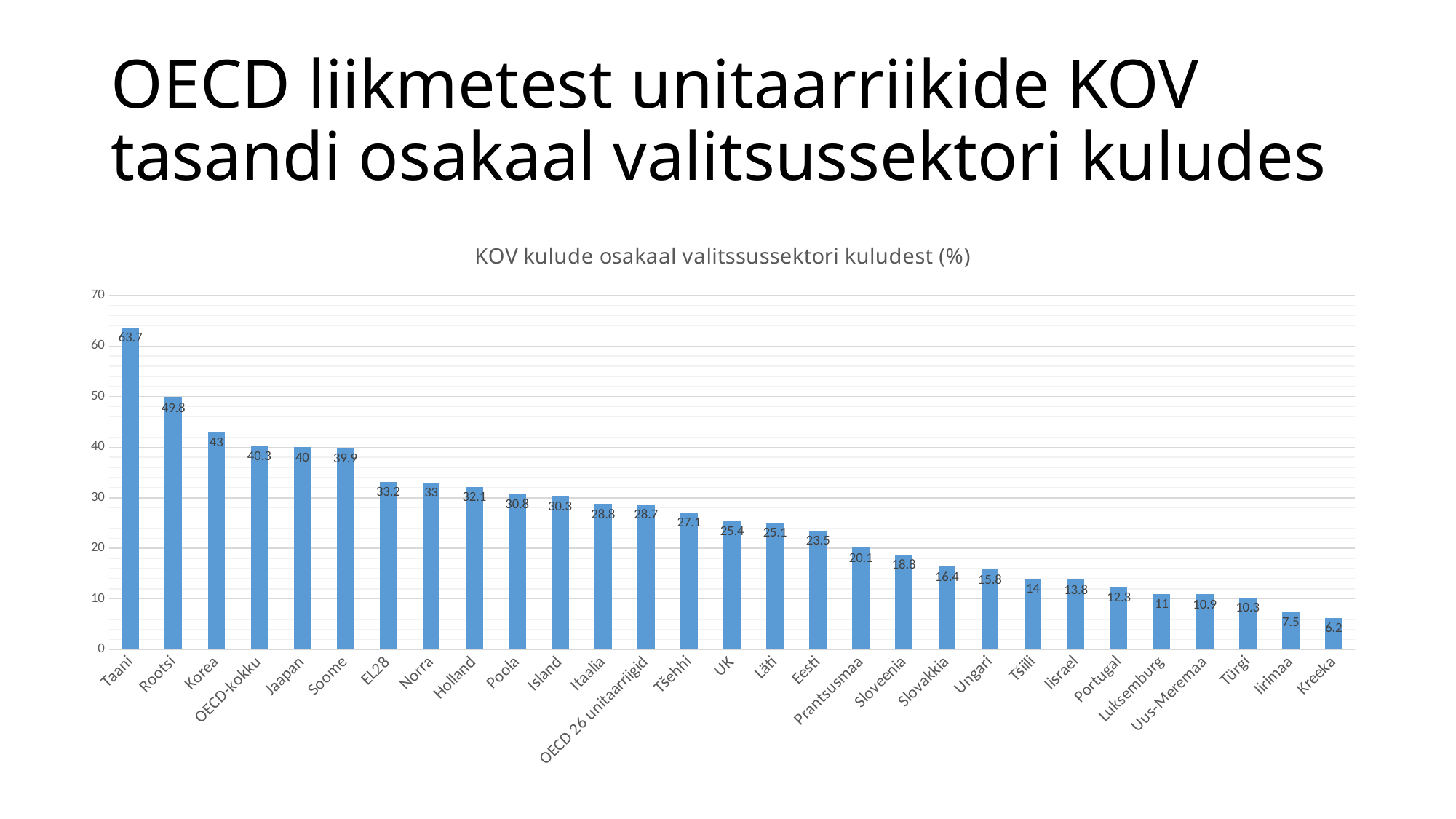
What is the value for Soome? 39.9 What kind of chart is shown on the slide? bar chart What is the value for OECD 26 unitaarriigid? 28.7 Which category has the highest value? Taani Do the values rise or fall from left to right along the x axis? fall What is the difference between the values for Taani and Rootsi? 13.9 What is the difference between the values for Eesti and Läti? 1.6 Is the value for Prantsusmaa greater or less than 30? less Which has a larger value, Korea or Holland? Korea How many categories are shown on the x axis? 29 What is the value for Eesti? 23.5 Which category has the lowest value? Kreeka